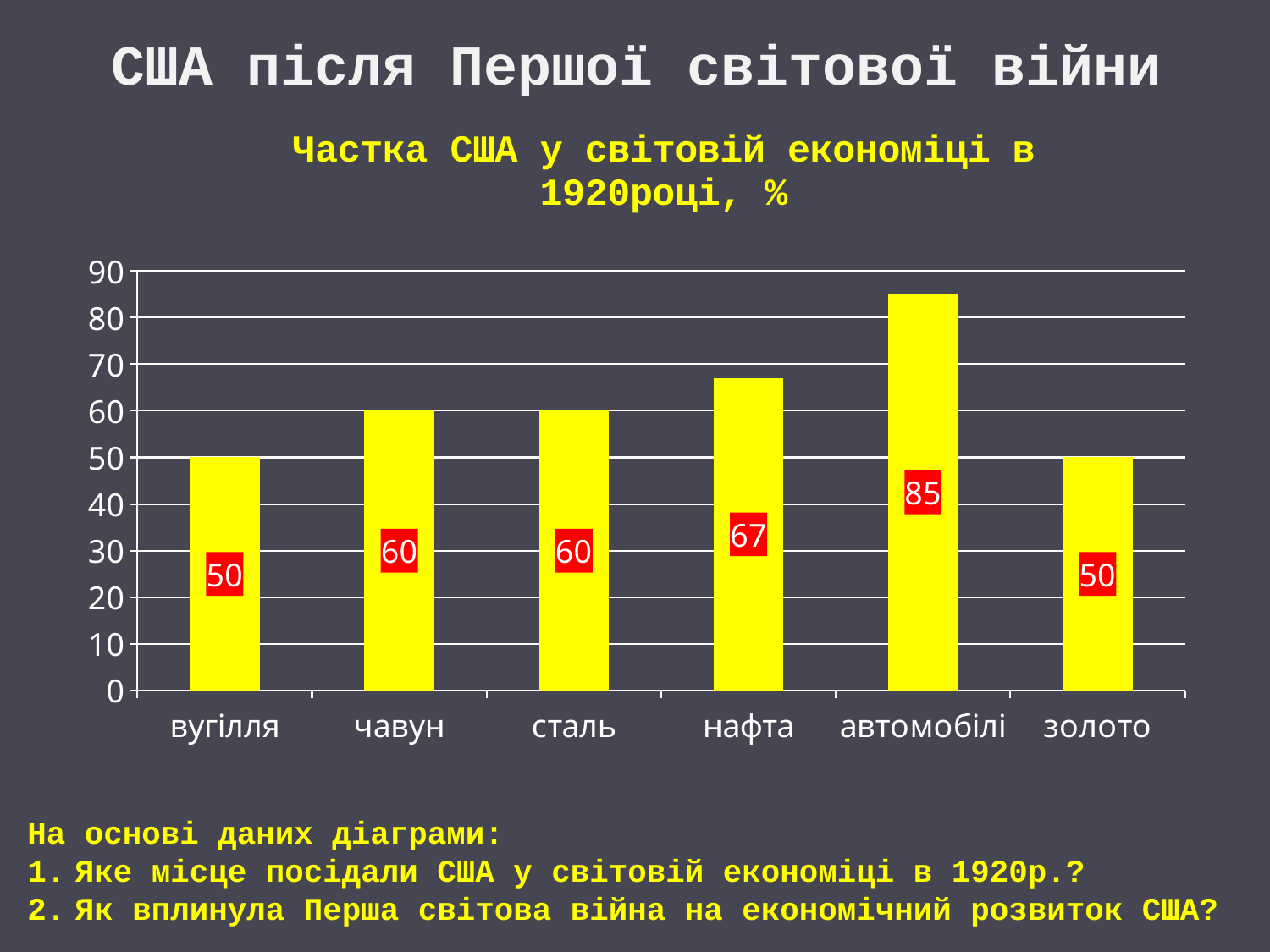
Is the value for автомобілі greater or less than 80? greater What is the title of the chart? Частка США у світовій економіці в 1920році, % What kind of chart is shown on the slide? bar chart Which is larger, the value for нафта or the value for сталь? нафта What is the difference between the values for чавун and золото? 10 What colour are the bars in the chart? yellow What is the value for автомобілі? 85 How many categories are shown on the x axis? 6 What is the difference between the values for автомобілі and нафта? 18 Which category has the highest value? автомобілі What is the value for нафта? 67 What is the value for вугілля? 50